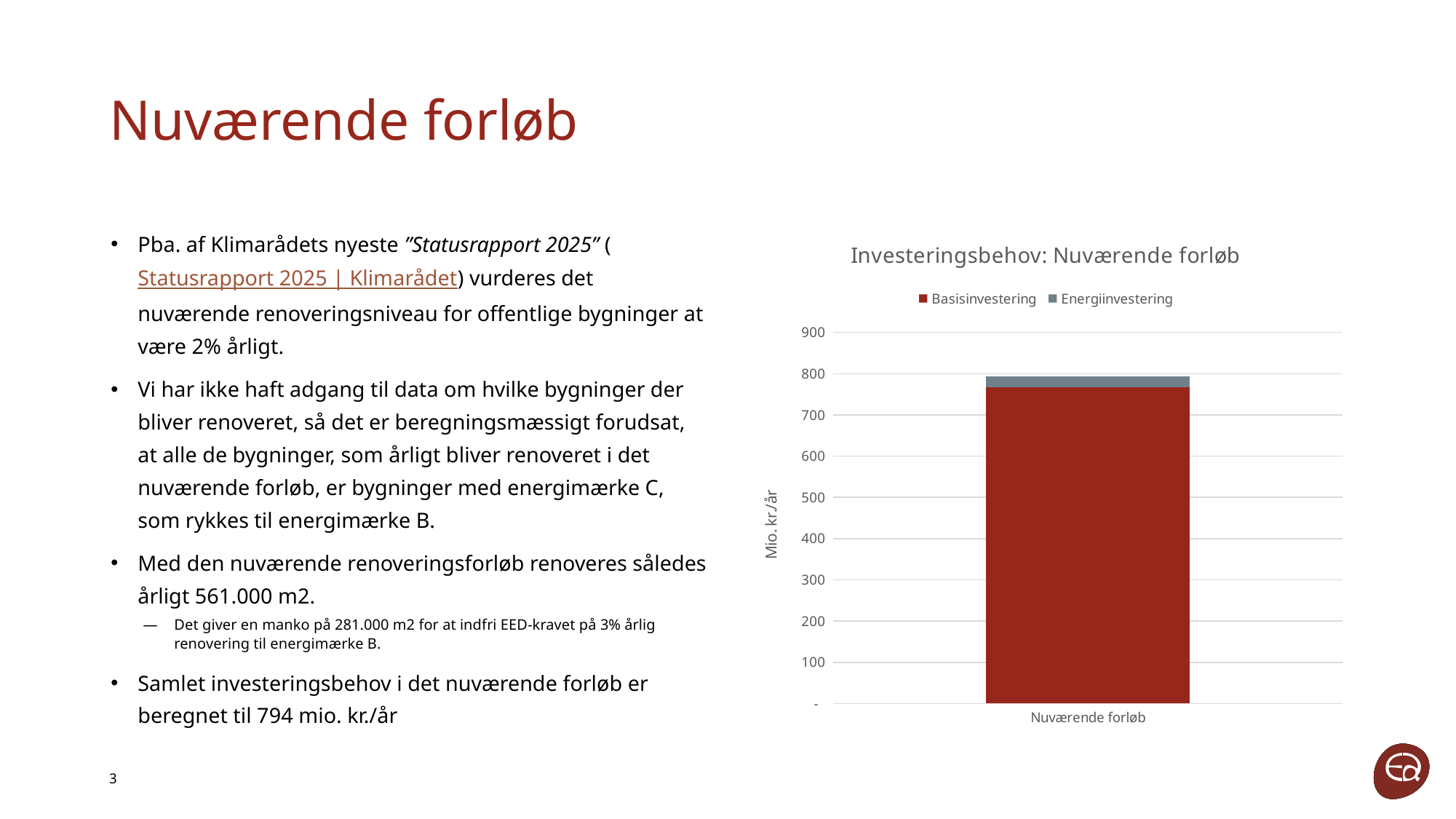
Is the value for Basisinvestering greater or less than 700? greater Which series makes up the larger part of the bar, Basisinvestering or Energiinvestering? Basisinvestering What is the label of the y axis? Mio. kr./år Is the total height of the stacked bar for Nuværende forløb greater or less than 900? less How many categories are shown on the x axis of the chart? 1 Is the total height of the stacked bar for Nuværende forløb greater or less than 600? greater What is the title of the chart? Investeringsbehov: Nuværende forløb What kind of chart is shown on the slide? bar chart How many series does the chart legend list? 2 Which series has the smallest value in the chart? Energiinvestering What is the label of the category on the x axis? Nuværende forløb